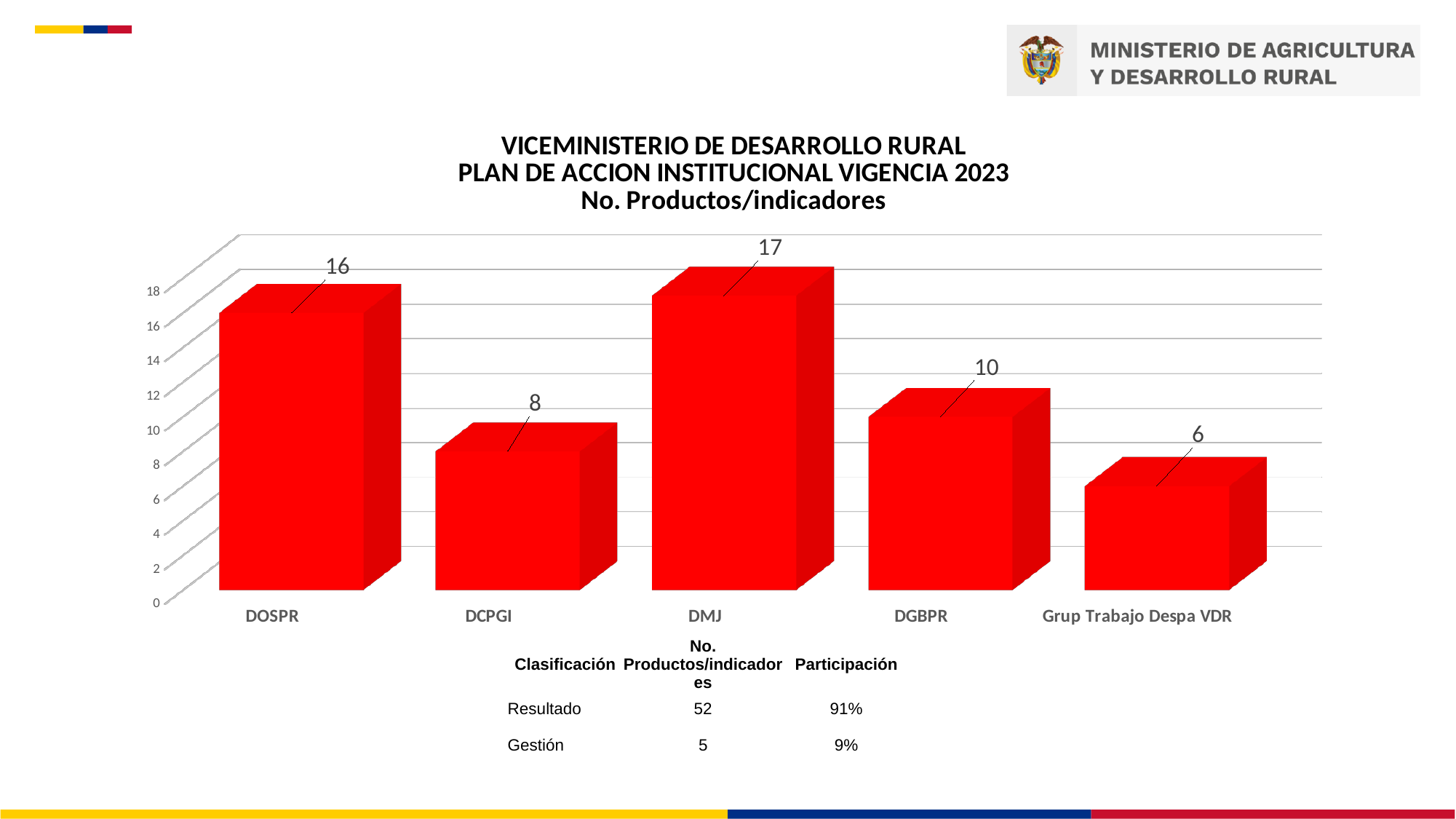
What is the value for DOSPR? 16 What colour are the bars in the chart? red What is the value for Grup Trabajo Despa VDR? 6 Which category has the highest number of productos/indicadores? DMJ How many categories are shown on the x axis? 5 Is the value for DGBPR greater or less than 12? less What is the difference between the values for DMJ and DGBPR? 7 What is the value for DMJ? 17 Which is larger, the value for DCPGI or the value for DGBPR? DGBPR Which category has the lowest number of productos/indicadores? Grup Trabajo Despa VDR What kind of chart is shown on the slide? bar chart What is the value for DCPGI? 8